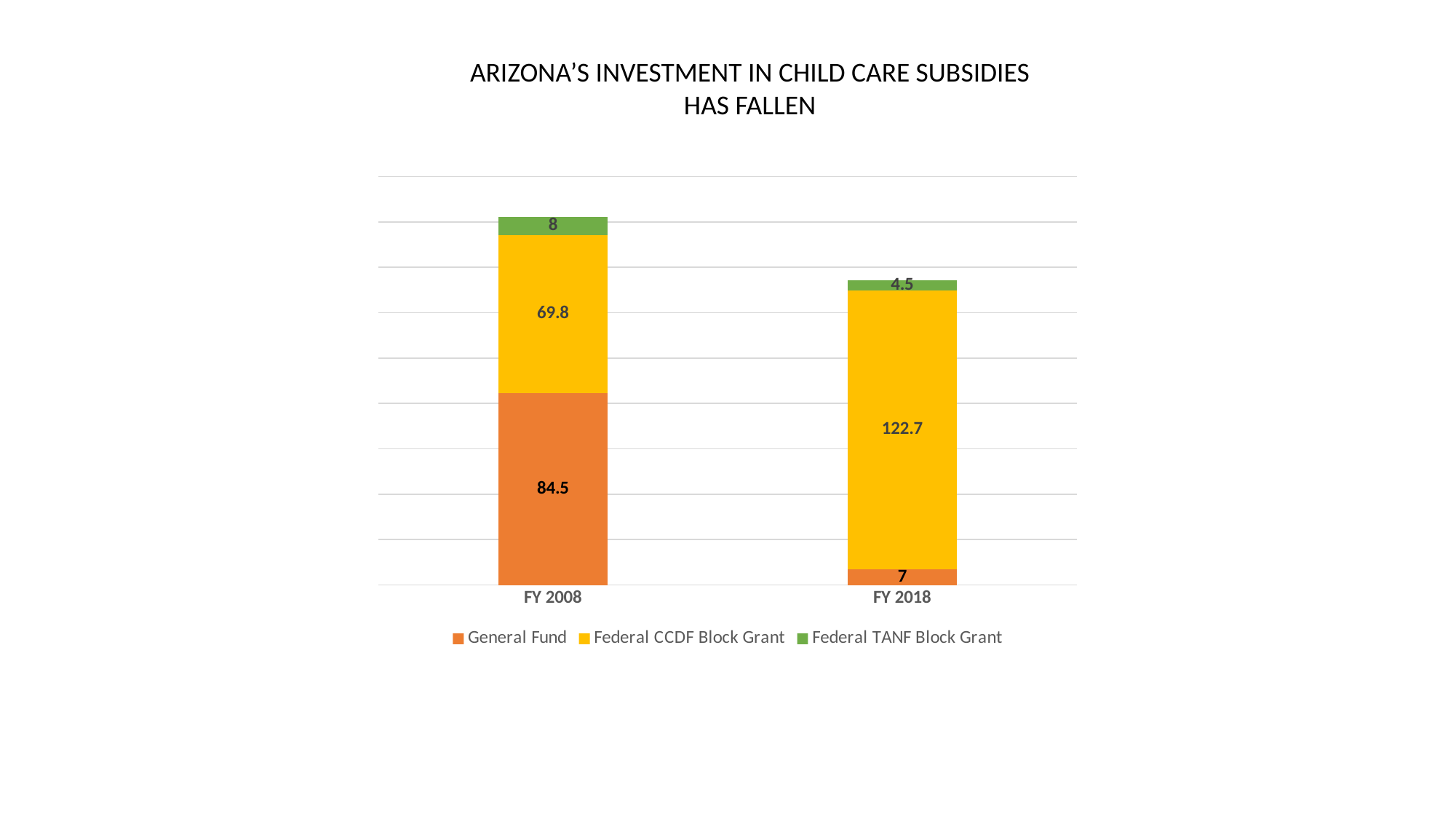
What is the Federal CCDF Block Grant value for FY 2018? 122.7 What is the General Fund value for FY 2018? 7 What is the Federal TANF Block Grant value for FY 2008? 8 Which series has the largest value in the FY 2018 bar? Federal CCDF Block Grant How many series does the legend list? 3 What is the total of the stacked bar for FY 2008? 162.3 Which series has the smallest value in the FY 2008 bar? Federal TANF Block Grant What is the General Fund value for FY 2008? 84.5 What is the difference between the General Fund values for FY 2008 and FY 2018? 77.5 What is the total of the stacked bar for FY 2018? 134.2 What kind of chart is shown on the slide? Stacked bar chart Which is larger, the Federal CCDF Block Grant value for FY 2008 or for FY 2018? FY 2018